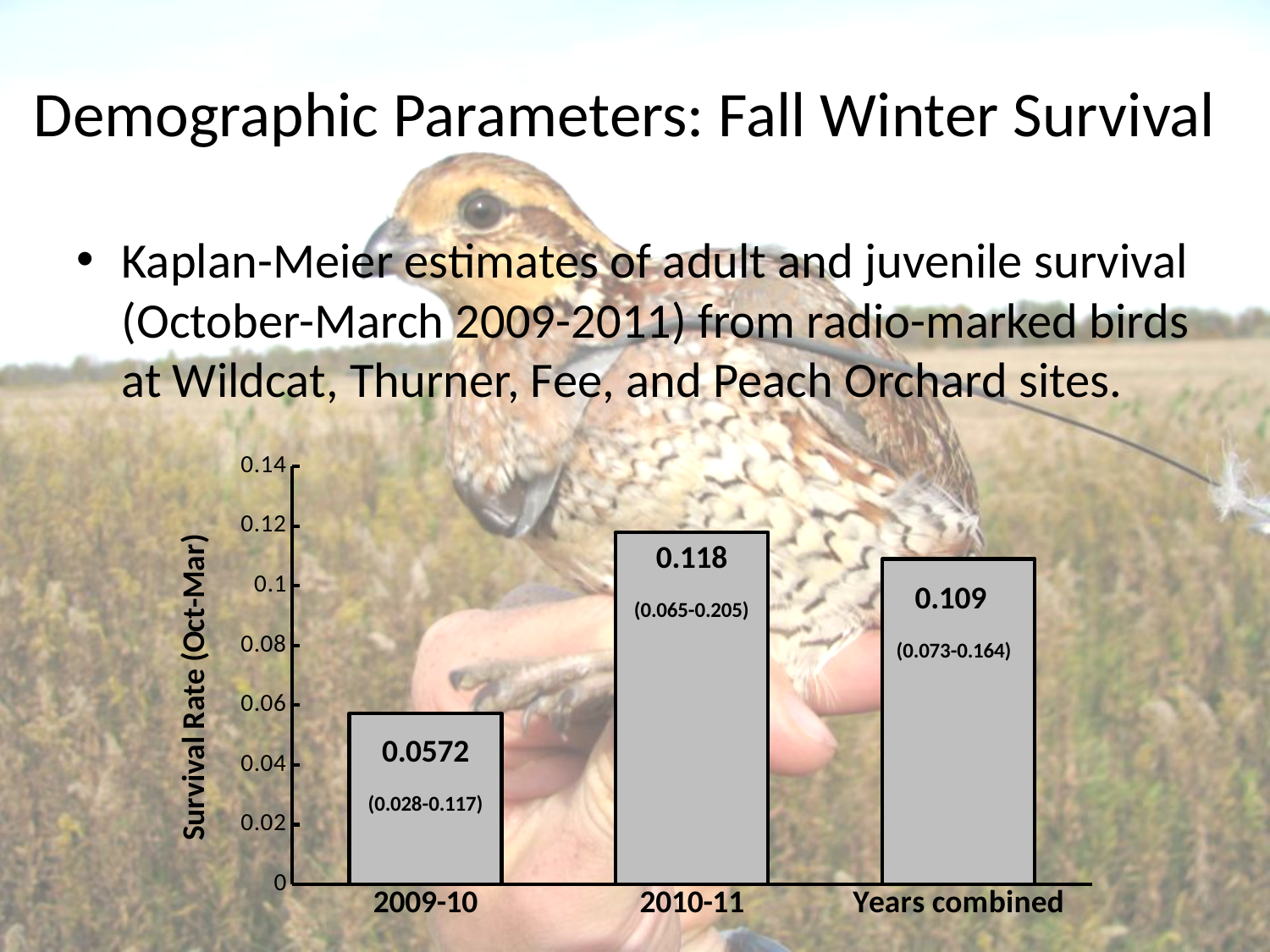
Which has a higher survival rate, 2009-10 or Years combined? Years combined What is the survival rate shown for 2010-11? 0.118 Which category has the lowest survival rate? 2009-10 What is the difference between the survival rates for 2010-11 and 2009-10? 0.0608 What is the survival rate shown for 2009-10? 0.0572 What is the survival rate shown for Years combined? 0.109 How many categories are shown on the x axis of the chart? 3 What kind of chart is shown on the slide? bar chart Is the survival rate for 2009-10 greater or less than 0.06? less What confidence interval is printed on the 2010-11 bar? (0.065-0.205) What is the label of the vertical axis of the chart? Survival Rate (Oct-Mar) Which category has the highest survival rate? 2010-11